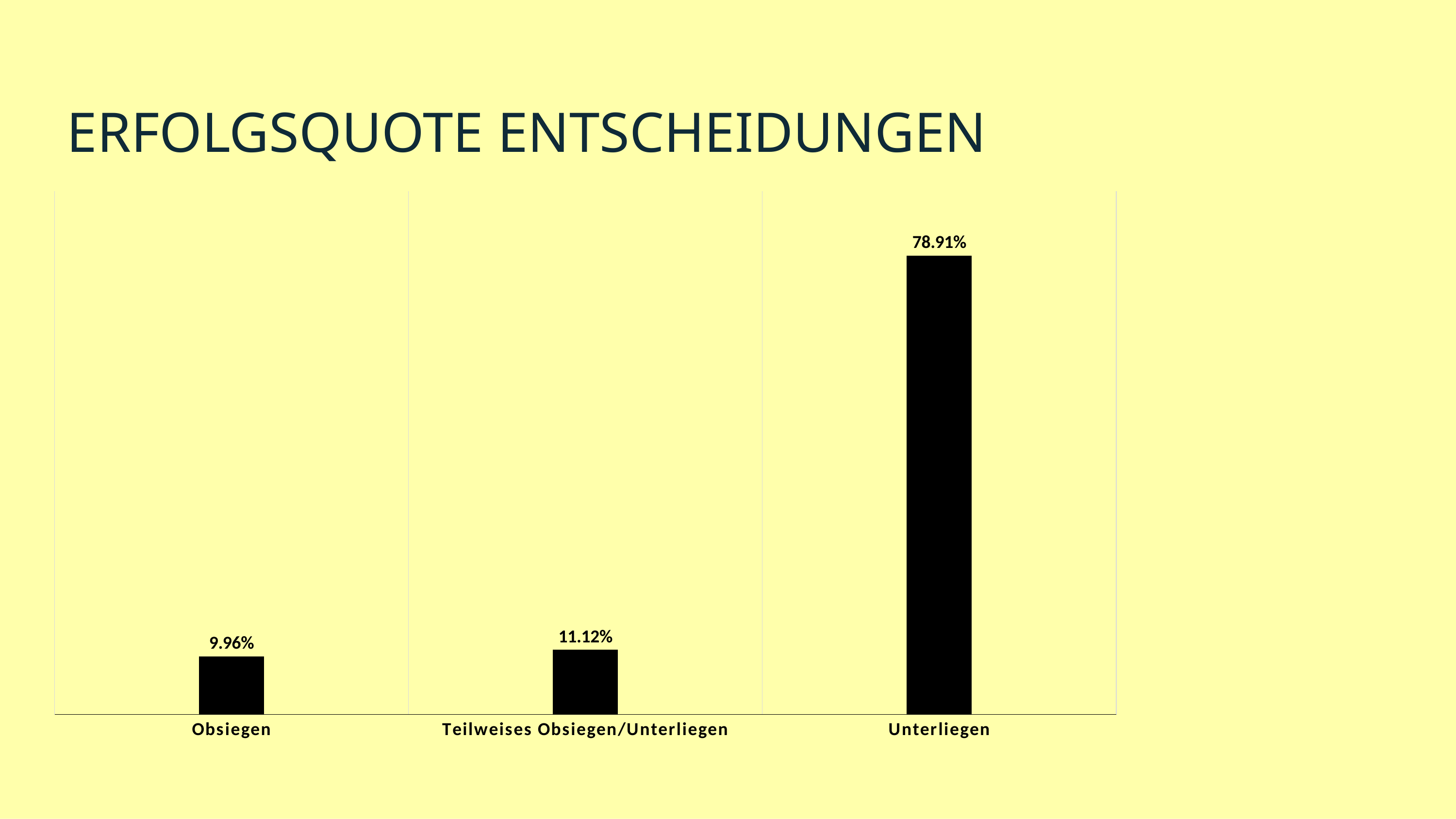
What kind of chart is shown on the slide? bar chart What is the difference between the values for Unterliegen and Obsiegen? 68.95% What is the value for Unterliegen? 78.91% Which category has the lowest value? Obsiegen How many categories are shown in the chart? 3 Which category has the highest value? Unterliegen What is the value for Obsiegen? 9.96% What is the value for Teilweises Obsiegen/Unterliegen? 11.12% What colour are the bars in the chart? black What is the title of the slide? ERFOLGSQUOTE ENTSCHEIDUNGEN What is the difference between the values for Teilweises Obsiegen/Unterliegen and Obsiegen? 1.16% Which is larger, the value for Obsiegen or the value for Unterliegen? Unterliegen